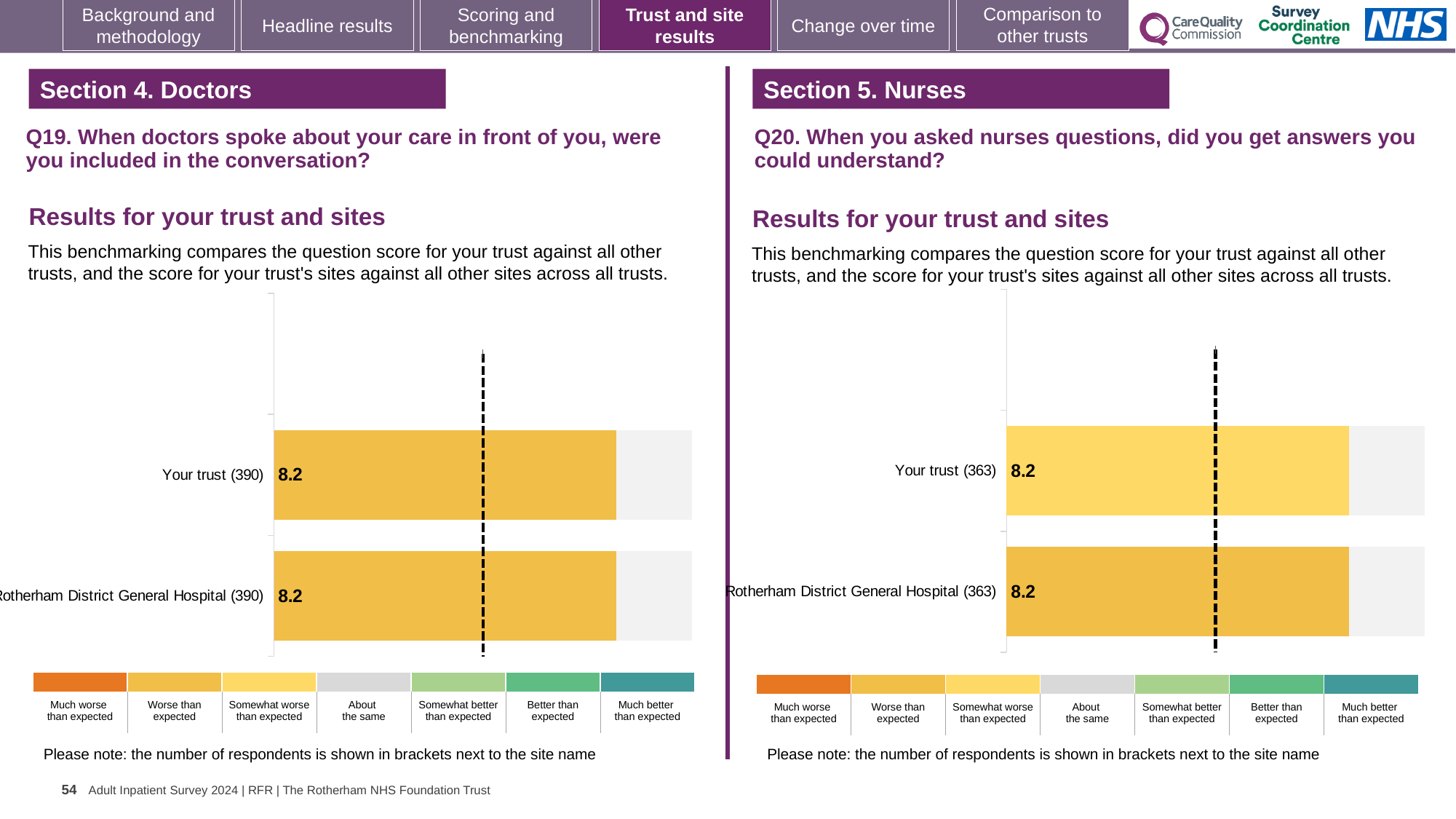
On the Q20 chart (right), how many respondents are shown in brackets for Rotherham District General Hospital? 363 What kind of chart is used on the Q19 chart (left)? Bar chart How many categories does the colour key below the Q20 chart (right) list? 7 On the Q19 chart (left), what is the difference between the score for Your trust and the score for Rotherham District General Hospital? 0 On the Q19 chart (left), how many respondents are shown in brackets for Your trust? 390 On the Q19 chart (left), how many bars are plotted? 2 On the Q20 chart (right), is the score for Your trust larger than, smaller than, or equal to the score for Rotherham District General Hospital? Equal On the Q20 chart (right), what is the score for Rotherham District General Hospital? 8.2 On the Q19 chart (left), what is the score for Your trust? 8.2 On the Q20 chart (right), how many bars are plotted? 2 On the Q20 chart (right), what is the score for Your trust? 8.2 On the Q19 chart (left), what is the score for Rotherham District General Hospital? 8.2